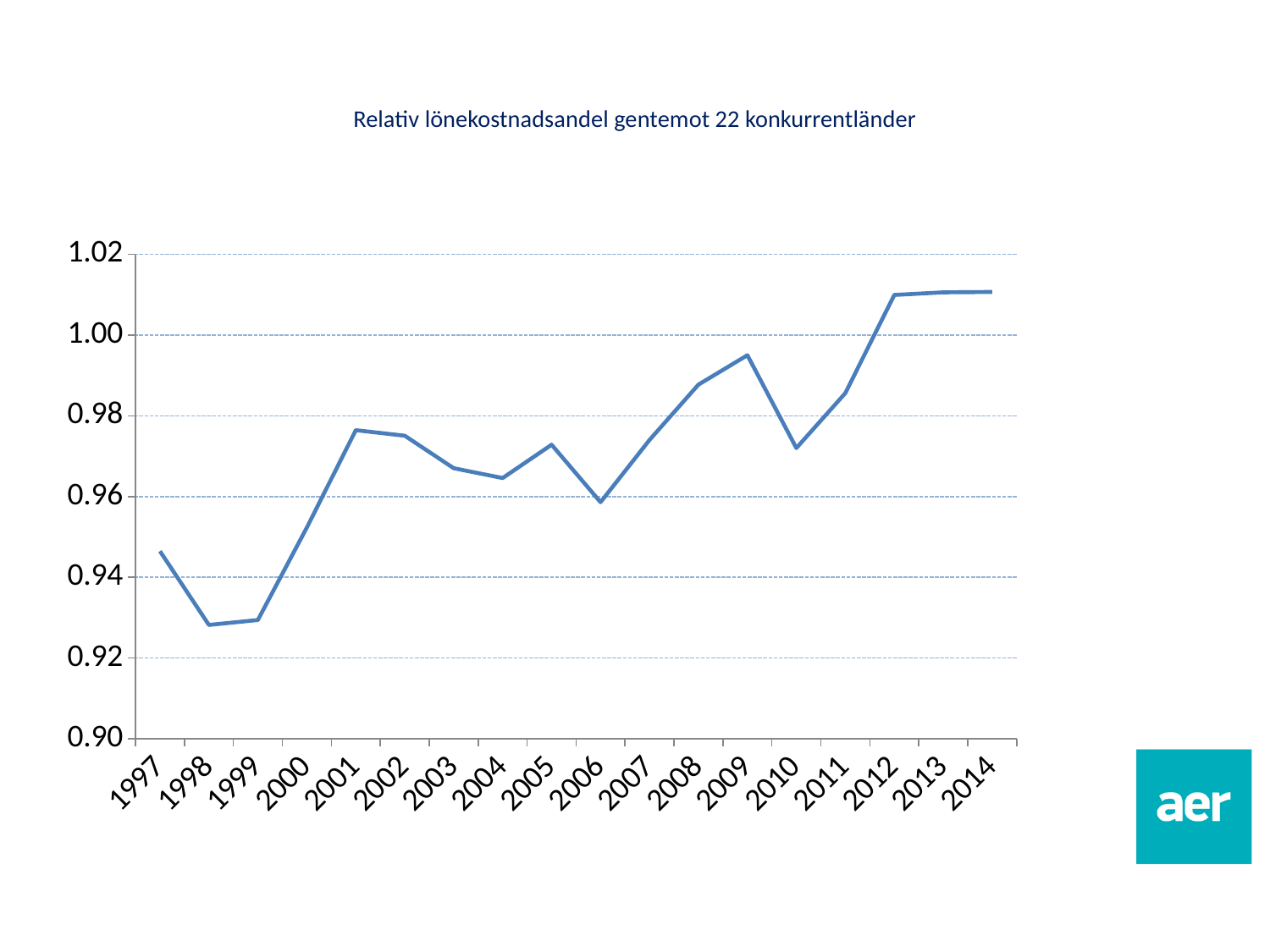
Which is larger, the value for 2009 or the value for 2010? 2009 Overall, does the line rise or fall from 1997 to 2014? rise What is the title of the chart? Relativ lönekostnadsandel gentemot 22 konkurrentländer What kind of chart is shown on the slide? line chart How many years are plotted along the x axis? 18 Is the value for 2009 greater or less than 1.00? less Which is larger, the value for 1998 or the value for 2001? 2001 Is the value for 2012 greater or less than 1.00? greater Is the value for 1998 greater or less than 0.94? less